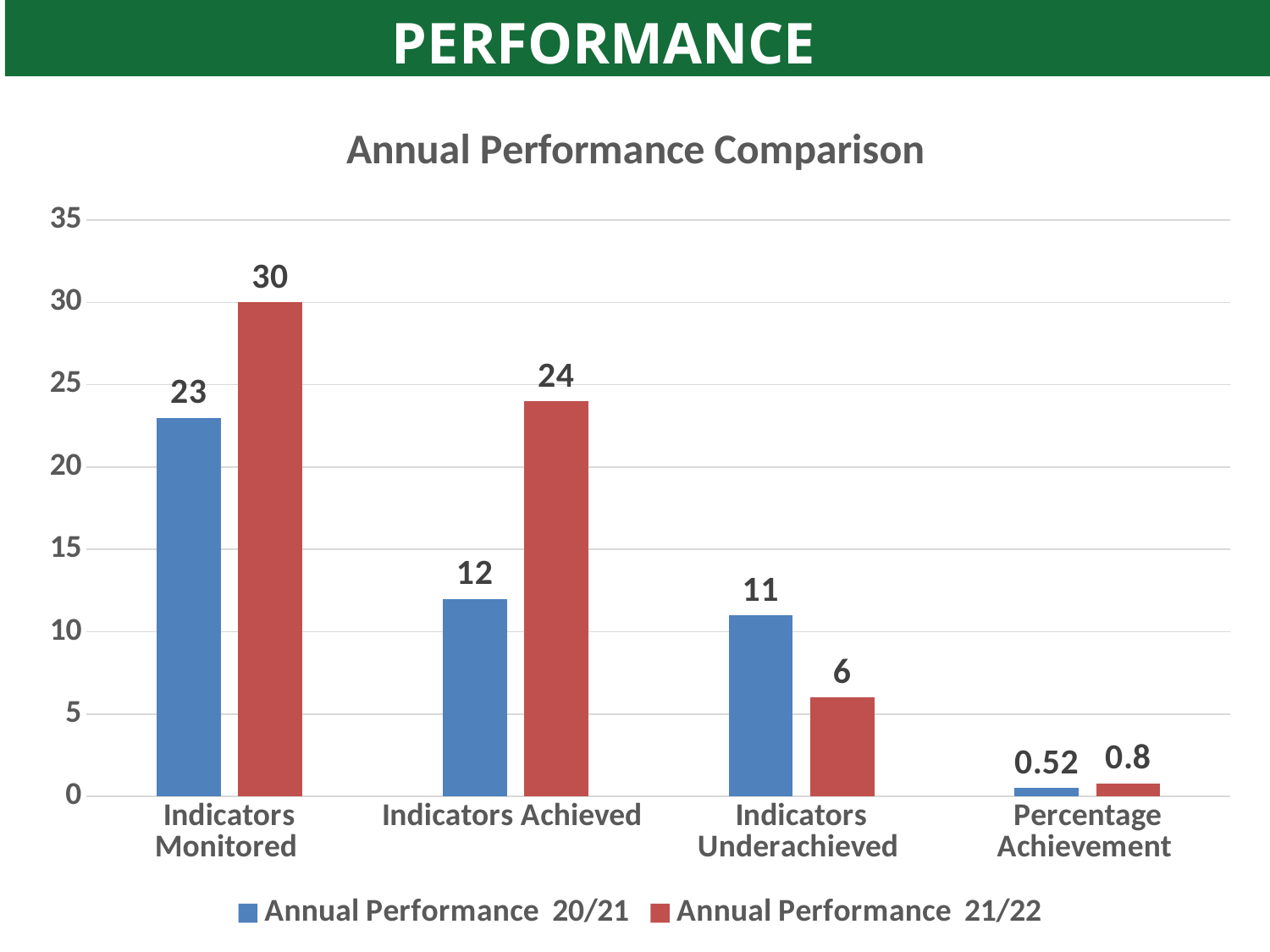
What is the value for Indicators Underachieved in the Annual Performance 21/22 series? 6 Which category has the lowest value in the Annual Performance 20/21 series? Percentage Achievement What is the value for Percentage Achievement in the Annual Performance 20/21 series? 0.52 What is the title of the chart? Annual Performance Comparison How many categories are shown on the x axis? 4 Which category has the highest value in the Annual Performance 21/22 series? Indicators Monitored How many series does the legend list? 2 What is the difference between the Annual Performance 21/22 and 20/21 values for Indicators Achieved? 12 What kind of chart is shown on the slide? Bar chart For Indicators Underachieved, which series has the larger value, Annual Performance 20/21 or Annual Performance 21/22? Annual Performance 20/21 What is the value for Indicators Achieved in the Annual Performance 21/22 series? 24 What is the value for Indicators Monitored in the Annual Performance 20/21 series? 23